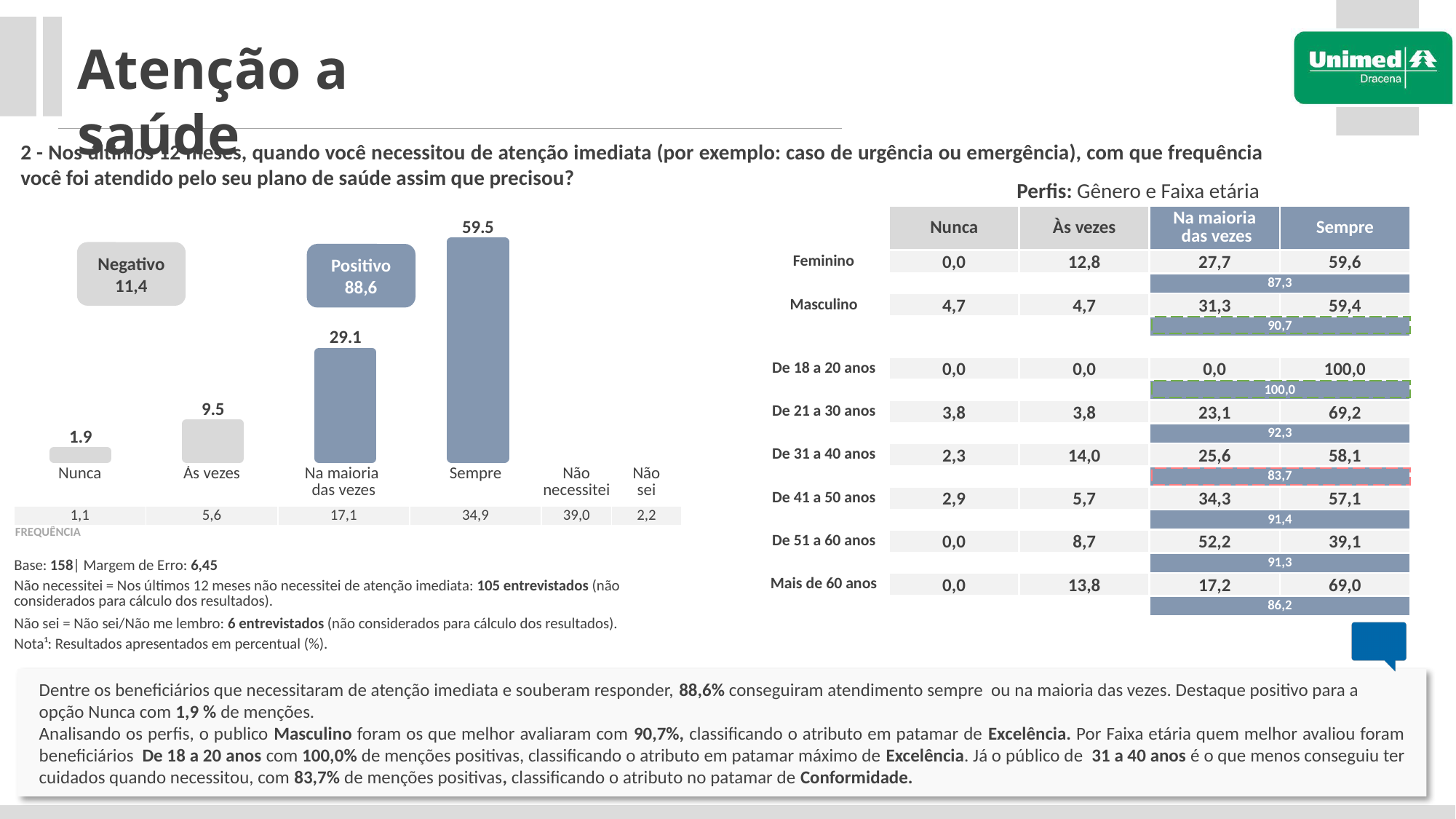
In the bar chart, do the values rise or fall from 'Nunca' to 'Sempre'? rise In the bar chart, which category with a plotted bar has the lowest value? Nunca In the bar chart, what is the value for 'Sempre'? 59.5 In the bar chart, what is the difference between the values for 'Às vezes' and 'Nunca'? 7.6 In the bar chart, what is the value for 'Na maioria das vezes'? 29.1 In the bar chart, what is the value for 'Às vezes'? 9.5 What value is shown in the 'Positivo' box next to the bar chart? 88,6 In the bar chart, which is larger, the value for 'Às vezes' or the value for 'Na maioria das vezes'? Na maioria das vezes In the bar chart, what is the value for 'Nunca'? 1.9 In the bar chart, what is the difference between the values for 'Sempre' and 'Na maioria das vezes'? 30.4 In the bar chart, which category has the highest value? Sempre What kind of chart is shown on the left of the slide? bar chart